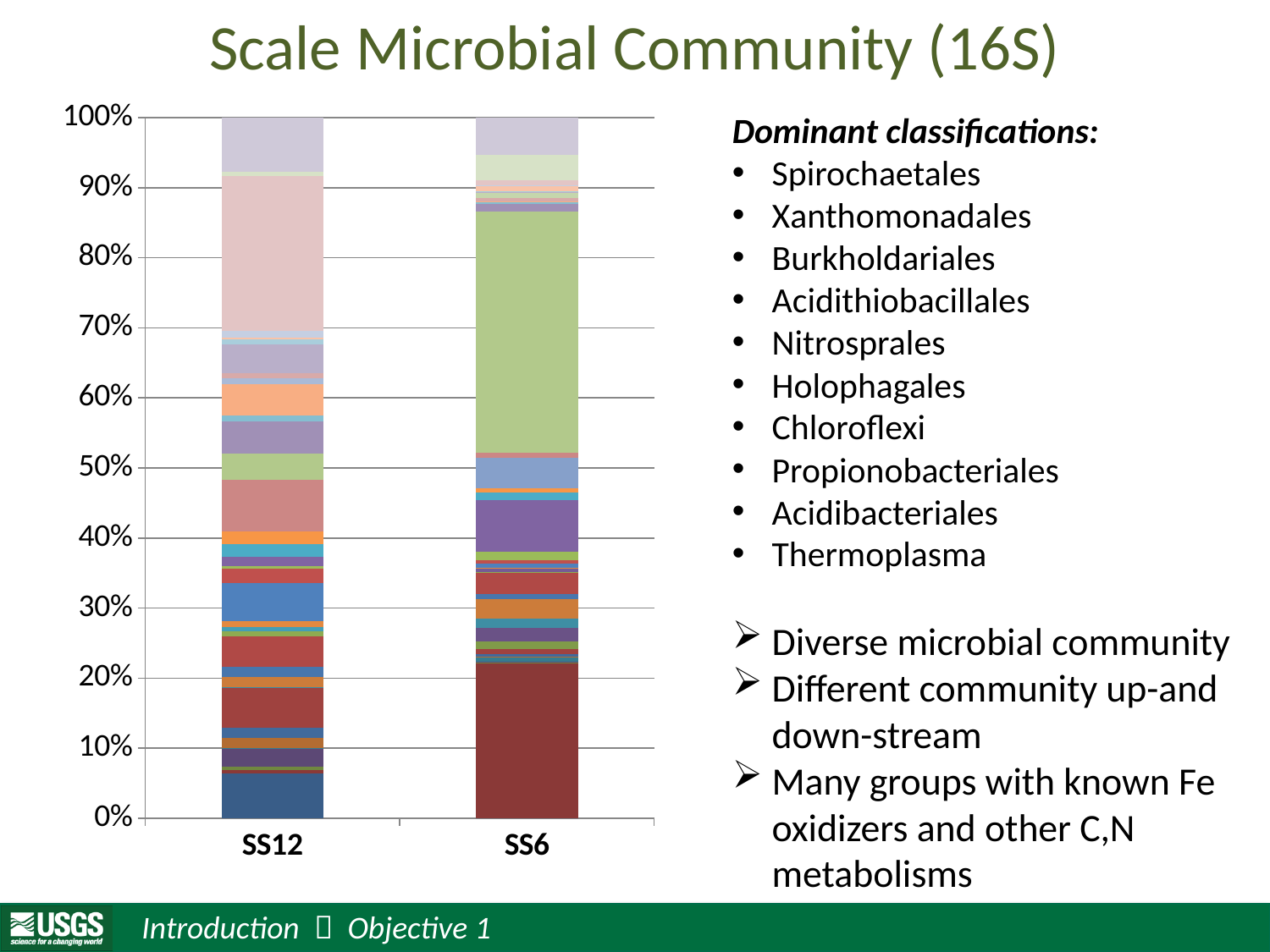
Is the large light green segment of the SS6 bar greater or less than 30%? greater What is the highest value shown on the y axis? 100% What kind of chart is shown on the slide? Stacked bar chart Is the bottom (dark red) segment of the SS6 bar greater or less than 20%? greater What is the total of the stacked bar for SS6? 100% What are the two category labels on the x axis? SS12 and SS6 How many categories (bars) are plotted on the x axis? 2 Is the bottom (dark blue) segment of the SS12 bar greater or less than 10%? less What is the total of the stacked bar for SS12? 100% Which bar has the larger bottom segment, SS12 or SS6? SS6